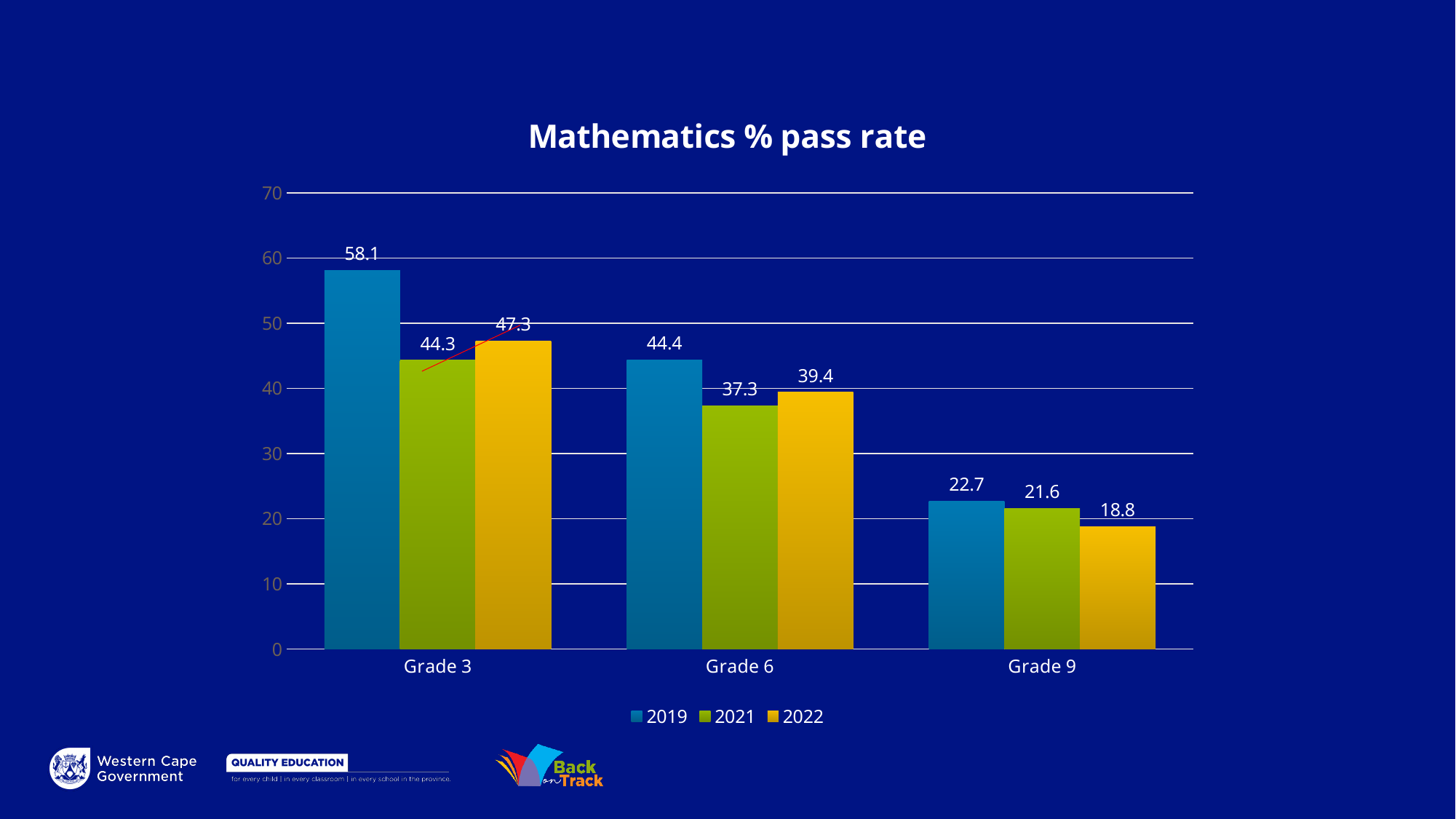
Is the 2019 Mathematics pass rate for Grade 6 greater or less than 40? greater What kind of chart is shown on the slide? Bar chart What is the title of the chart? Mathematics % pass rate What is the 2021 Mathematics pass rate for Grade 9? 21.6 Which is larger for Grade 6: the 2021 pass rate or the 2022 pass rate? 2022 What is the 2019 Mathematics pass rate for Grade 3? 58.1 Which grade has the highest 2019 Mathematics pass rate? Grade 3 What is the difference between the 2019 and 2022 Mathematics pass rates for Grade 3? 10.8 How many grade categories are shown on the x axis? 3 How many series does the legend list? 3 What is the 2022 Mathematics pass rate for Grade 6? 39.4 Which grade has the lowest 2022 Mathematics pass rate? Grade 9